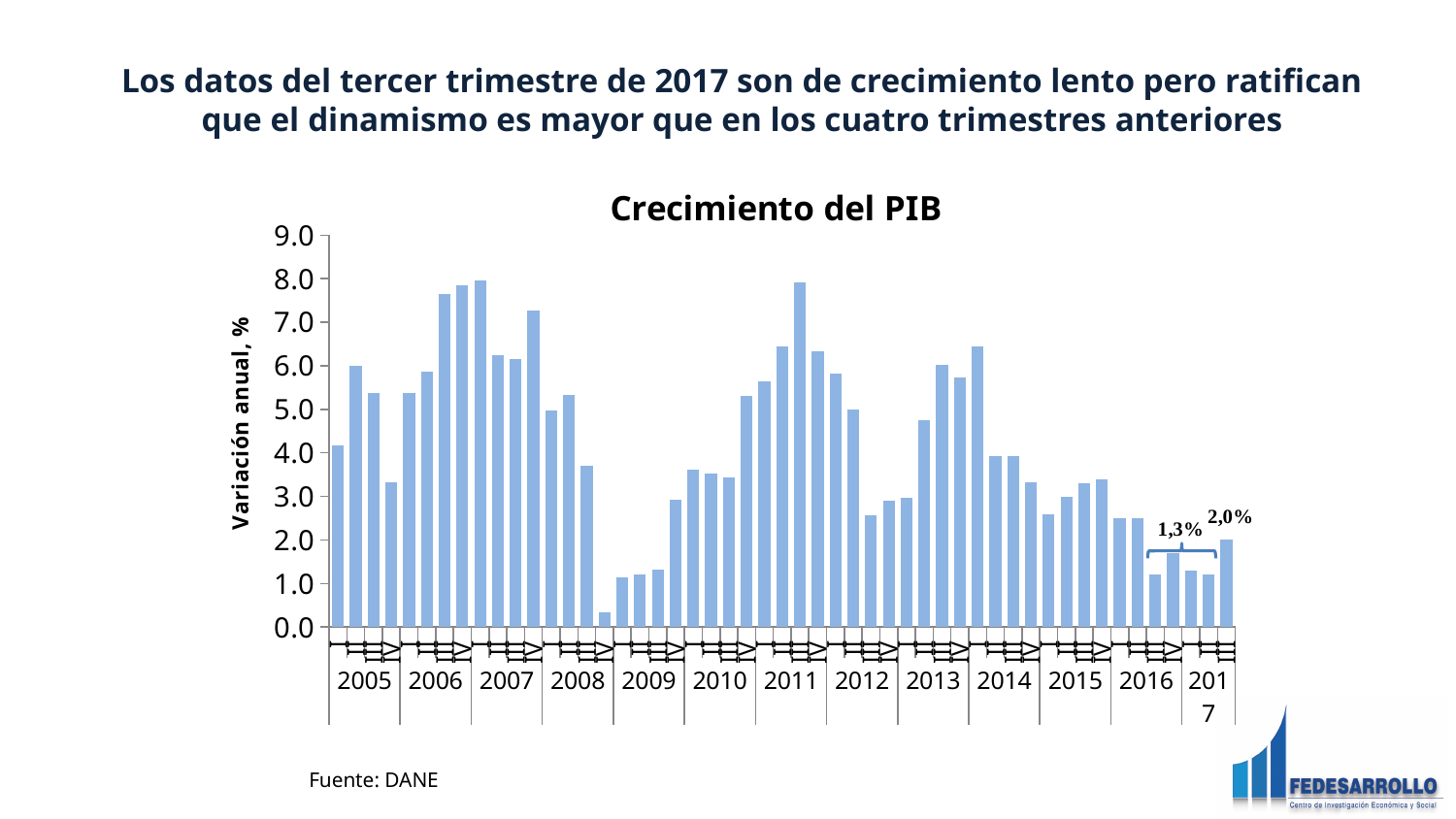
Is the value of the tallest bar in 2011 greater or less than 7.0? greater How many bars are plotted for 2017? 3 What is the label of the vertical axis? Variación anual, % What value is printed above the bracket spanning the 2016 bars? 1,3% What value is printed above the last bar of 2017? 2,0% What kind of chart is shown on the slide? Bar chart From 2013 to 2016, do the bars generally rise or fall? fall What is the title of the chart? Crecimiento del PIB Is the value of the first bar of 2009 greater or less than 1.0? greater In which year does the lowest bar of the chart appear? 2008 How many years are labeled along the x axis? 13 Is the last bar of 2017 higher or lower than the first bar of 2017? higher